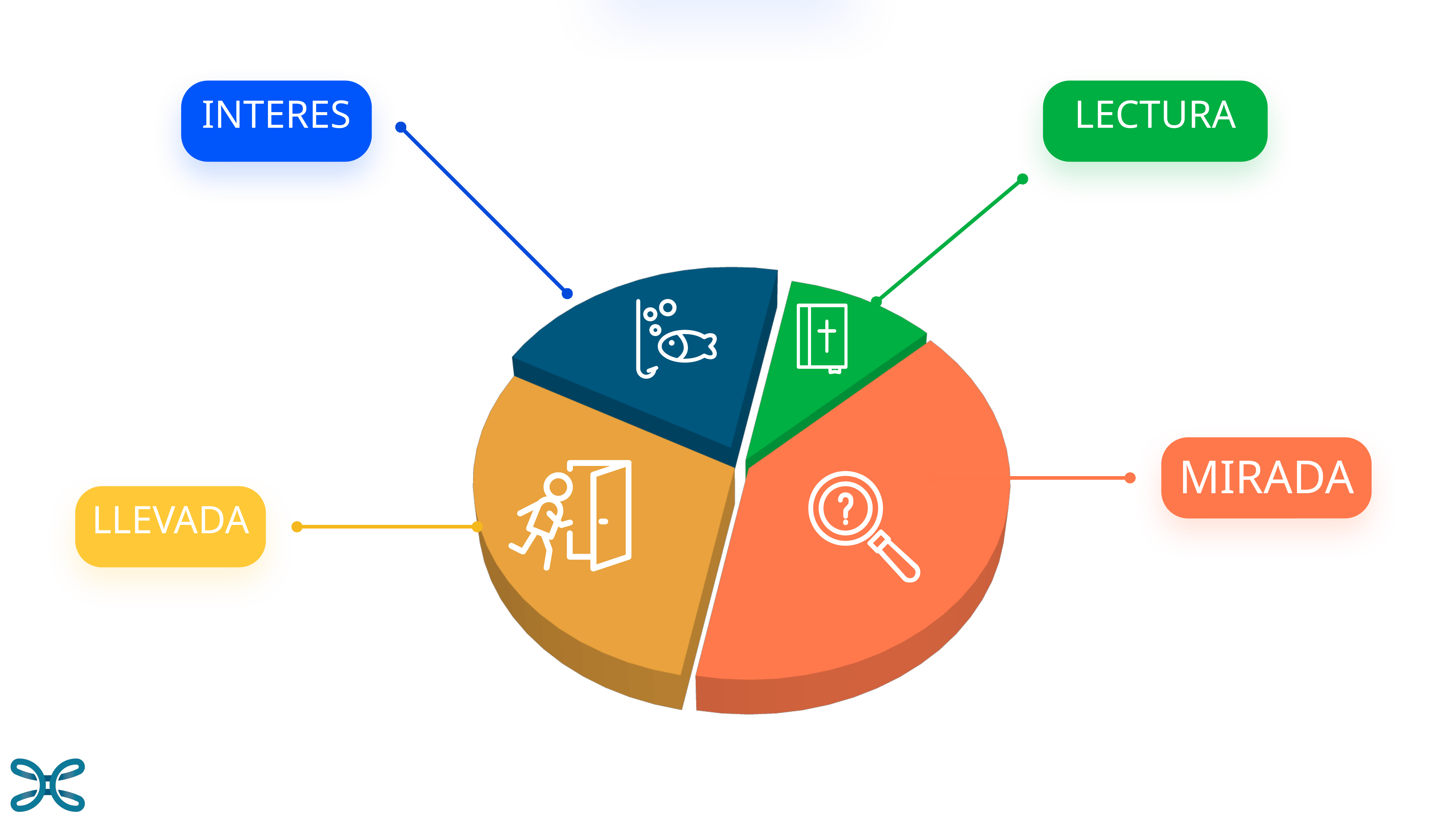
Which slice is larger, INTERES or LECTURA? INTERES Which slice of the pie chart is the largest? MIRADA What colour is the MIRADA slice of the pie chart? orange How many slices does the pie chart have? 4 What kind of chart is shown on the slide? pie chart Which slice is larger, MIRADA or LECTURA? MIRADA Which slice of the pie chart is the smallest? LECTURA Which slice of the pie chart is coloured green? LECTURA Which slice is larger, MIRADA or LLEVADA? MIRADA